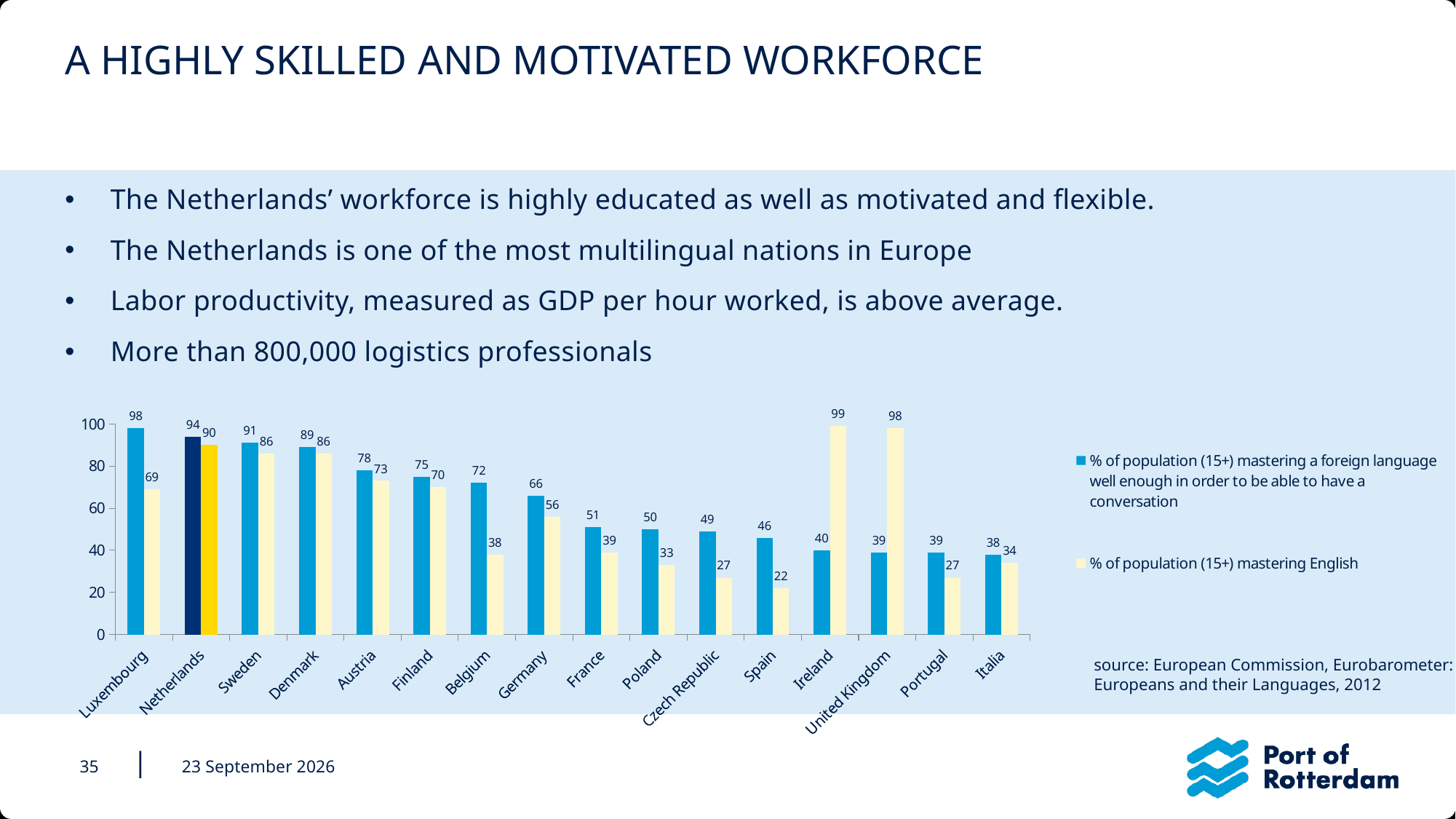
Which country has the highest value for % of population (15+) mastering a foreign language well enough to have a conversation? Luxembourg What source is cited for the chart data? European Commission, Eurobarometer: Europeans and their Languages, 2012 Which is larger: the % mastering English in the United Kingdom or in Sweden? United Kingdom How many series does the chart legend list? 2 Which country has the lowest value for % of population (15+) mastering English? Spain What kind of chart is shown on the slide? Bar chart What is the difference between Luxembourg's foreign language value and its English value? 29 What percentage of the population (15+) in the Netherlands masters a foreign language well enough to have a conversation? 94 Do the values for % of population mastering a foreign language generally rise or fall from Luxembourg to Italia along the x axis? Fall Which country has the highest value for % of population (15+) mastering English? Ireland What percentage of the population (15+) in Germany masters English? 56 How many countries are shown on the x axis of the chart? 16